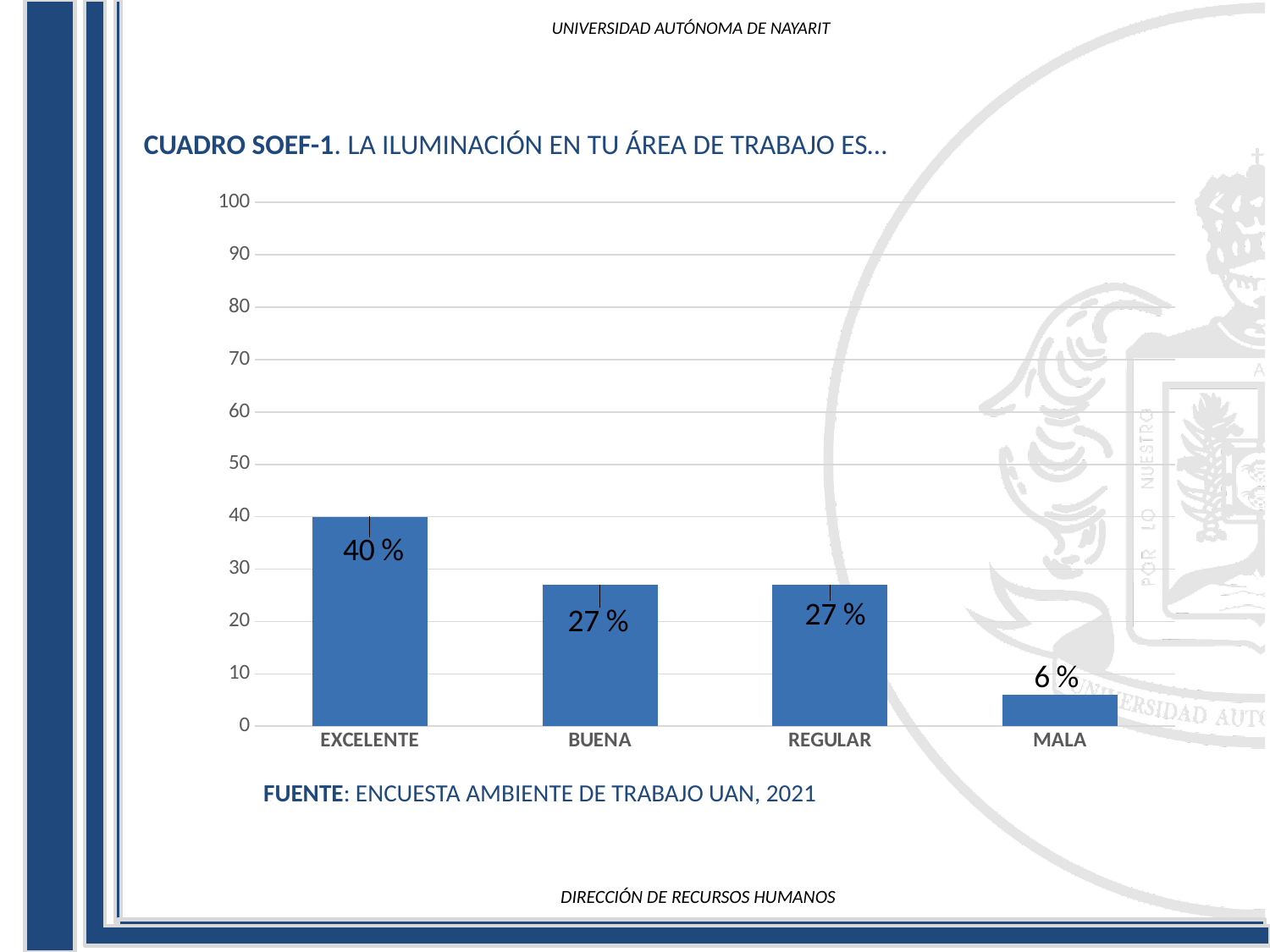
How many categories are shown on the x axis? 4 Is the value for EXCELENTE greater or less than 30? greater What is the difference between the values for EXCELENTE and MALA? 34 % What is the source cited below the chart? ENCUESTA AMBIENTE DE TRABAJO UAN, 2021 What kind of chart is shown on the slide? bar chart What is the value for EXCELENTE? 40 % What is the value for BUENA? 27 % What is the value for MALA? 6 % Which category has the lowest value? MALA Which is larger, the value for BUENA or the value for MALA? BUENA What is the difference between the values for EXCELENTE and REGULAR? 13 % Which category has the highest value? EXCELENTE